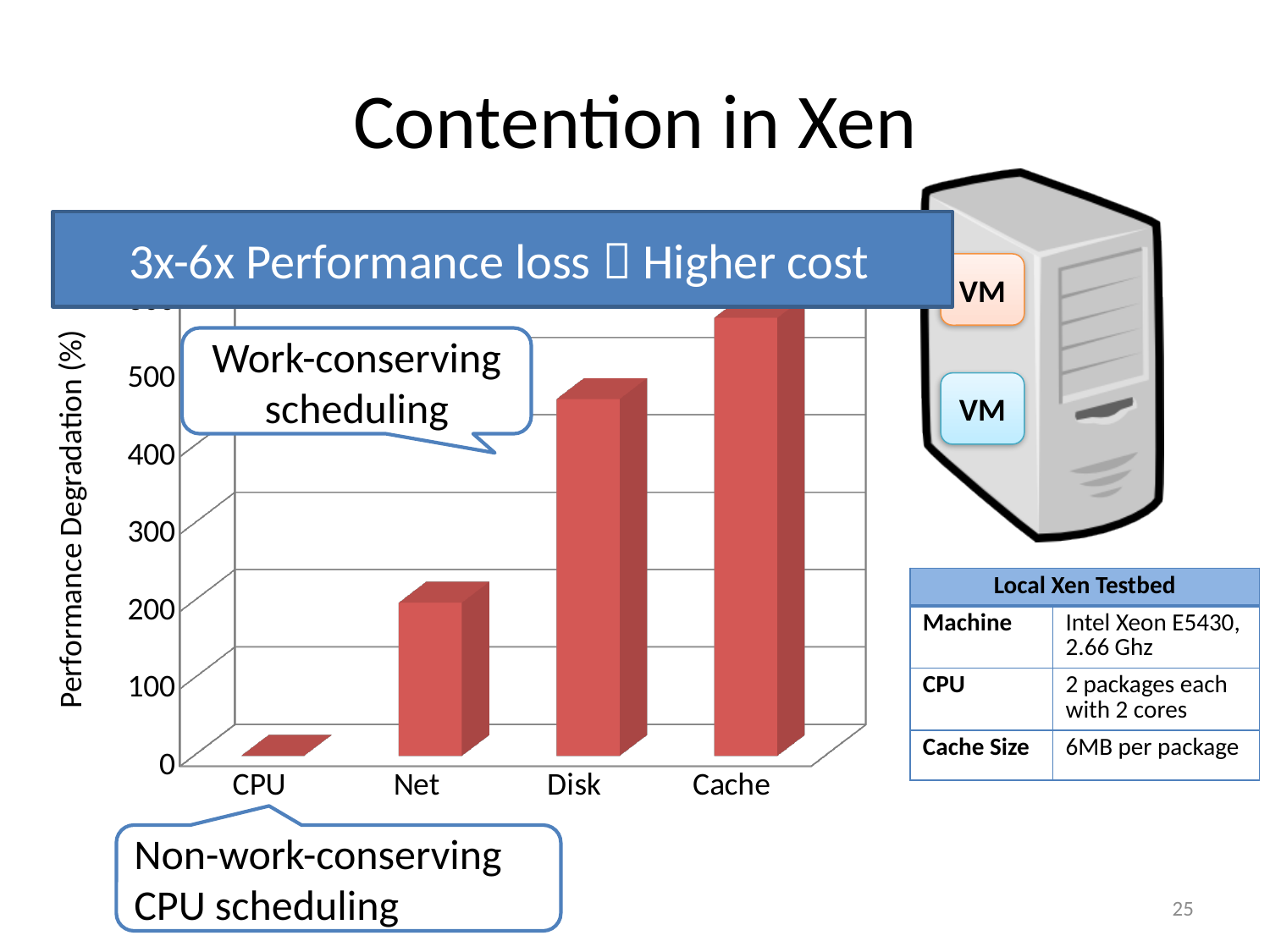
Is the value for Cache greater or less than 500? greater Is the value for Net greater or less than 300? less Which category has the highest performance degradation? Cache Do the bar values rise or fall from CPU to Cache along the x axis? rise Which has a larger performance degradation, Net or Disk? Disk What is the label of the vertical axis of the chart? Performance Degradation (%) Which has a larger performance degradation, CPU or Net? Net How many categories are shown on the x axis of the chart? 4 Is the value for Disk greater or less than 400? greater What kind of chart is shown on the slide? bar chart Which category has the lowest performance degradation? CPU